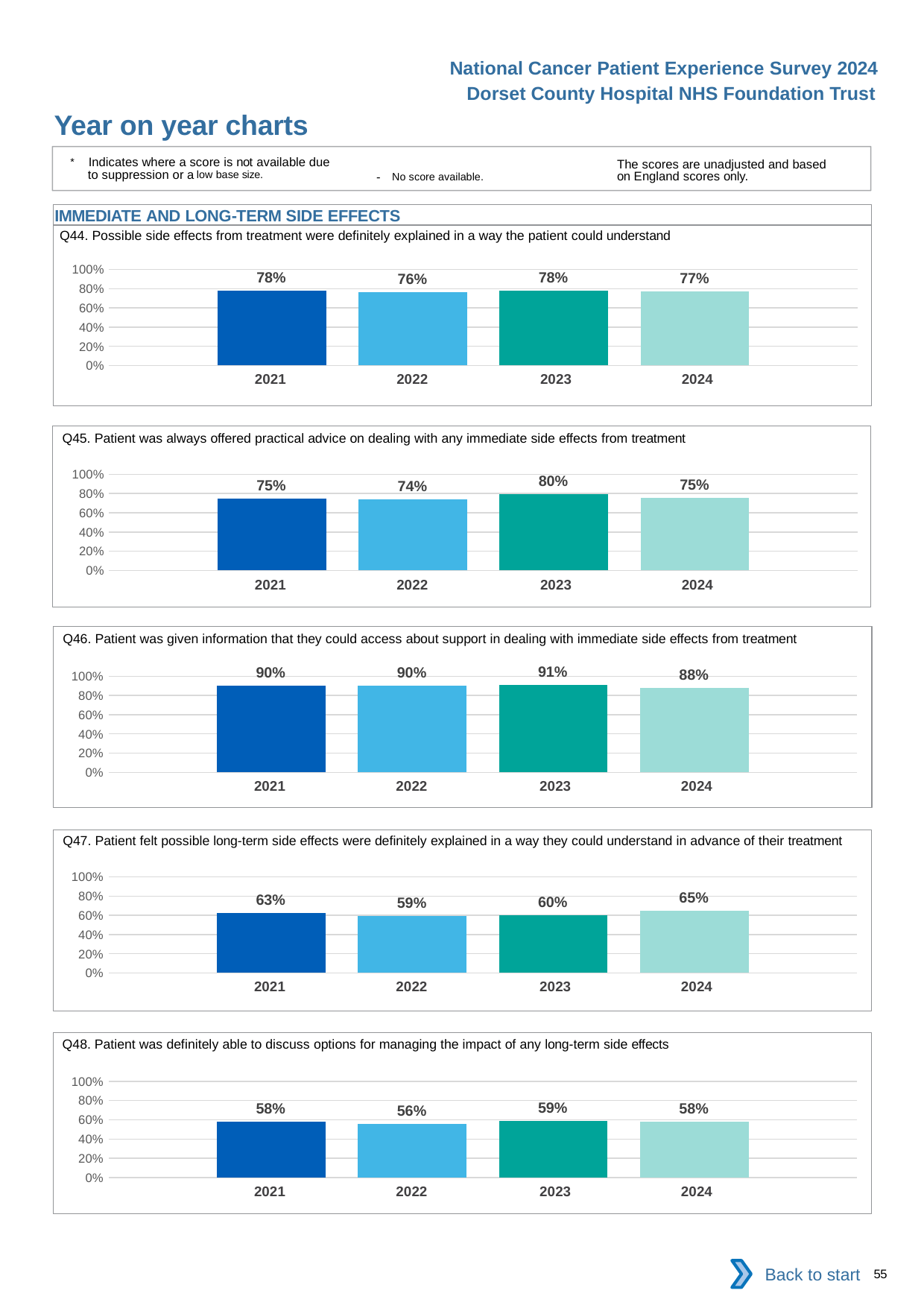
How many years are shown in the Q44 chart? 4 In the Q48 chart, what is the value for 2022? 56% In the Q45 chart, what is the difference between the 2023 and 2022 values? 6 percentage points What type of chart is the Q45 chart? Bar chart How many charts are shown on the slide? 5 In the Q47 chart, what is the difference between the 2024 and 2022 values? 6 percentage points In the Q47 chart, which is larger, the value for 2021 or the value for 2024? 2024 In the Q46 chart, what is the value for 2023? 91% In the Q48 chart, which year has the highest value? 2023 In the Q44 chart, what is the value for 2022? 76% In the Q45 chart, which year has the highest value? 2023 In the Q46 chart, which year has the lowest value? 2024